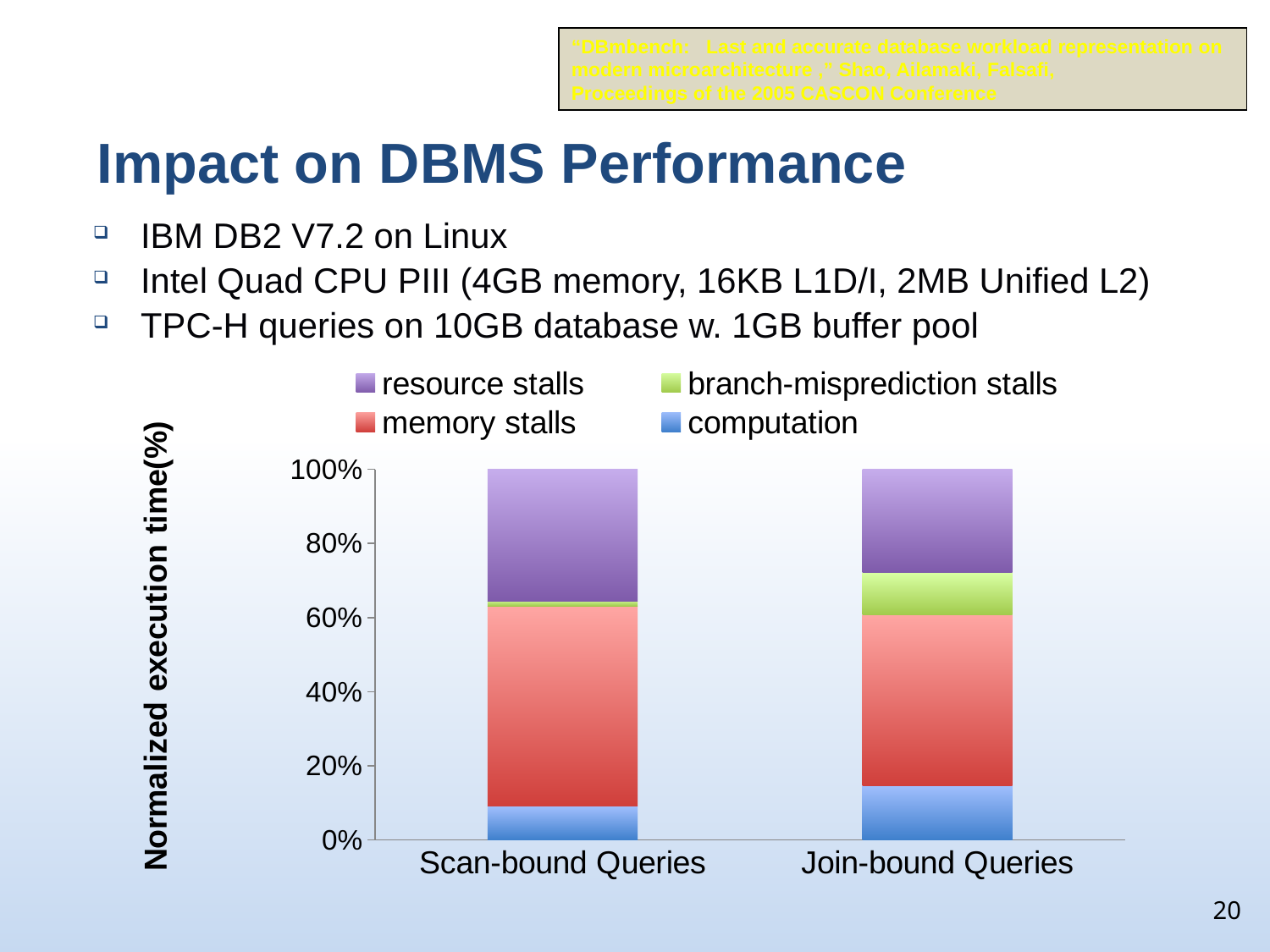
Is the computation segment for Scan-bound Queries greater or less than 20%? less What kind of chart is shown on the slide? stacked bar chart Which category has the larger resource stalls segment, Scan-bound Queries or Join-bound Queries? Scan-bound Queries Is the resource stalls segment for Join-bound Queries greater or less than 20%? greater Which category has the larger computation segment, Scan-bound Queries or Join-bound Queries? Join-bound Queries Is the memory stalls segment for Scan-bound Queries greater or less than 40%? greater Which series is shown in purple in the chart's legend? resource stalls What is the total height of the stacked bar for Scan-bound Queries? 100% What is the title of the chart's y axis? Normalized execution time(%) How many series does the chart's legend list? 4 Which category has the larger branch-misprediction stalls segment, Scan-bound Queries or Join-bound Queries? Join-bound Queries How many query categories are shown on the x axis of the chart? 2